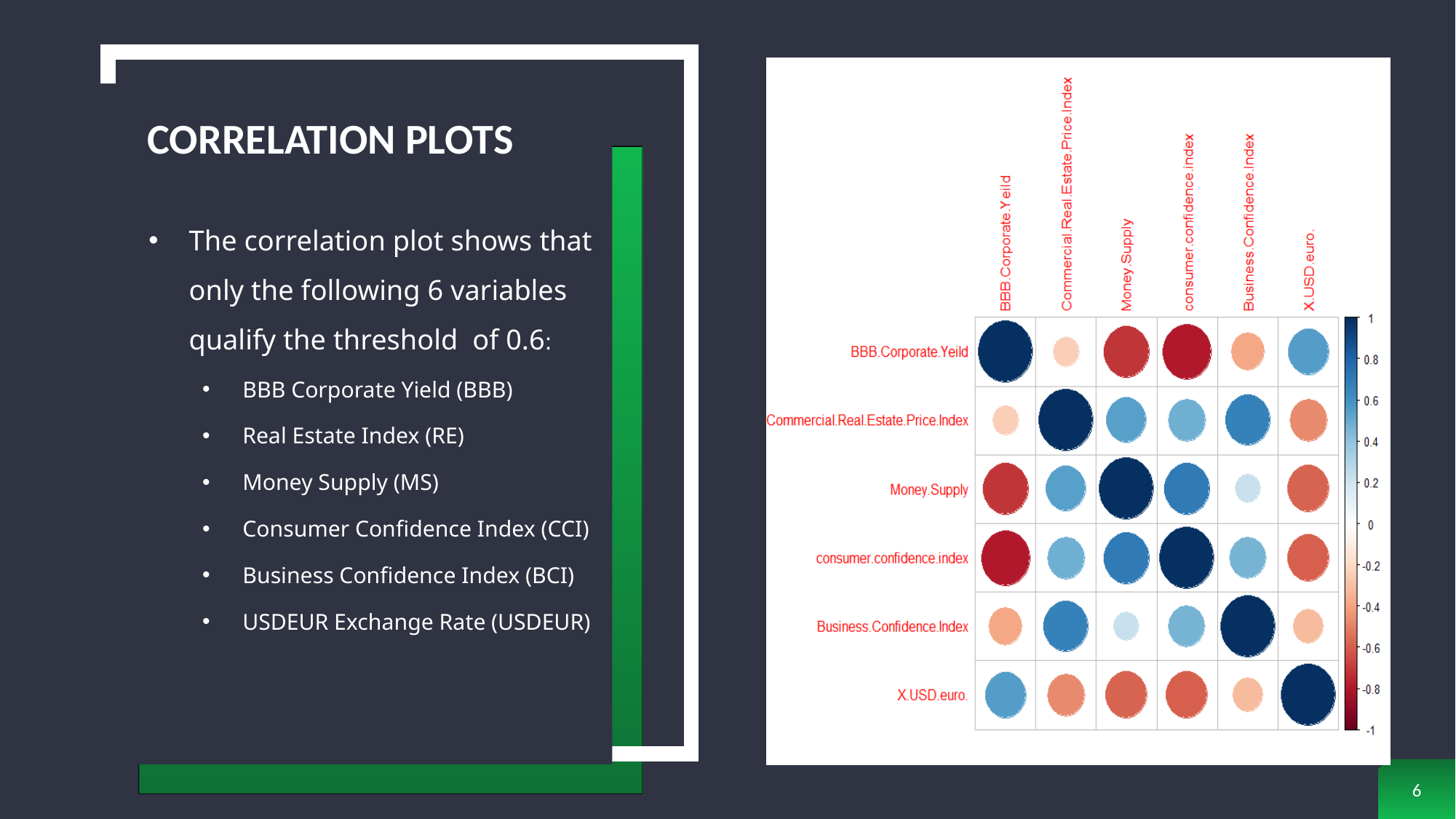
What is the maximum value shown on the colour scale of the correlation plot? 1 What kind of chart is shown on the slide? Correlation plot Is the correlation between BBB.Corporate.Yeild and consumer.confidence.index greater or less than 0? less Is the correlation between X.USD.euro. and Money.Supply greater or less than 0? less Is the correlation between Money.Supply and Business.Confidence.Index greater or less than 0.6? less Which is larger: the correlation between BBB.Corporate.Yeild and X.USD.euro., or the correlation between BBB.Corporate.Yeild and Money.Supply? BBB.Corporate.Yeild and X.USD.euro. Which is larger: the correlation between Money.Supply and consumer.confidence.index, or the correlation between Money.Supply and Business.Confidence.Index? Money.Supply and consumer.confidence.index Which variable has the most strongly negative correlation with BBB.Corporate.Yeild? consumer.confidence.index How many variables are included in the correlation plot? 6 What is the minimum value shown on the colour scale of the correlation plot? -1